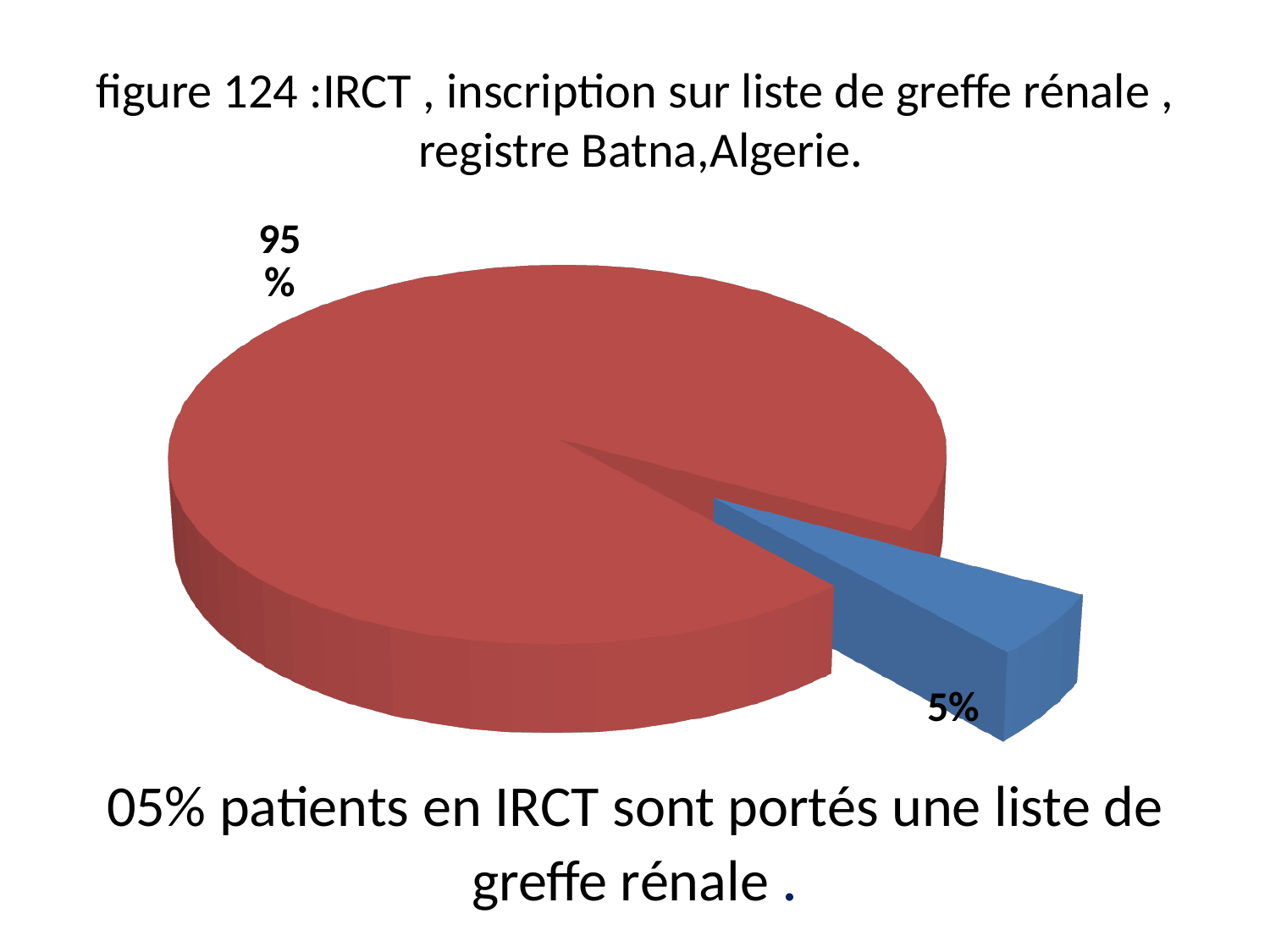
Which is larger, the red slice or the blue slice? the red slice How many slices does the pie chart have? 2 Which slice of the pie chart is the smallest? the blue slice (5%) Which slice of the pie chart is pulled out (exploded) from the rest of the pie? the blue slice (5%) What is the difference in percentage points between the red slice and the blue slice? 90 What percentage is shown for the red slice of the pie chart? 95% What percentage is shown for the blue slice of the pie chart? 5% What kind of chart is shown on the slide? pie chart What share of the pie does the red slice represent? 95% What is the figure number given in the chart title? figure 124 Which slice of the pie chart is the largest? the red slice (95%) What share of the pie does the blue slice represent? 5%